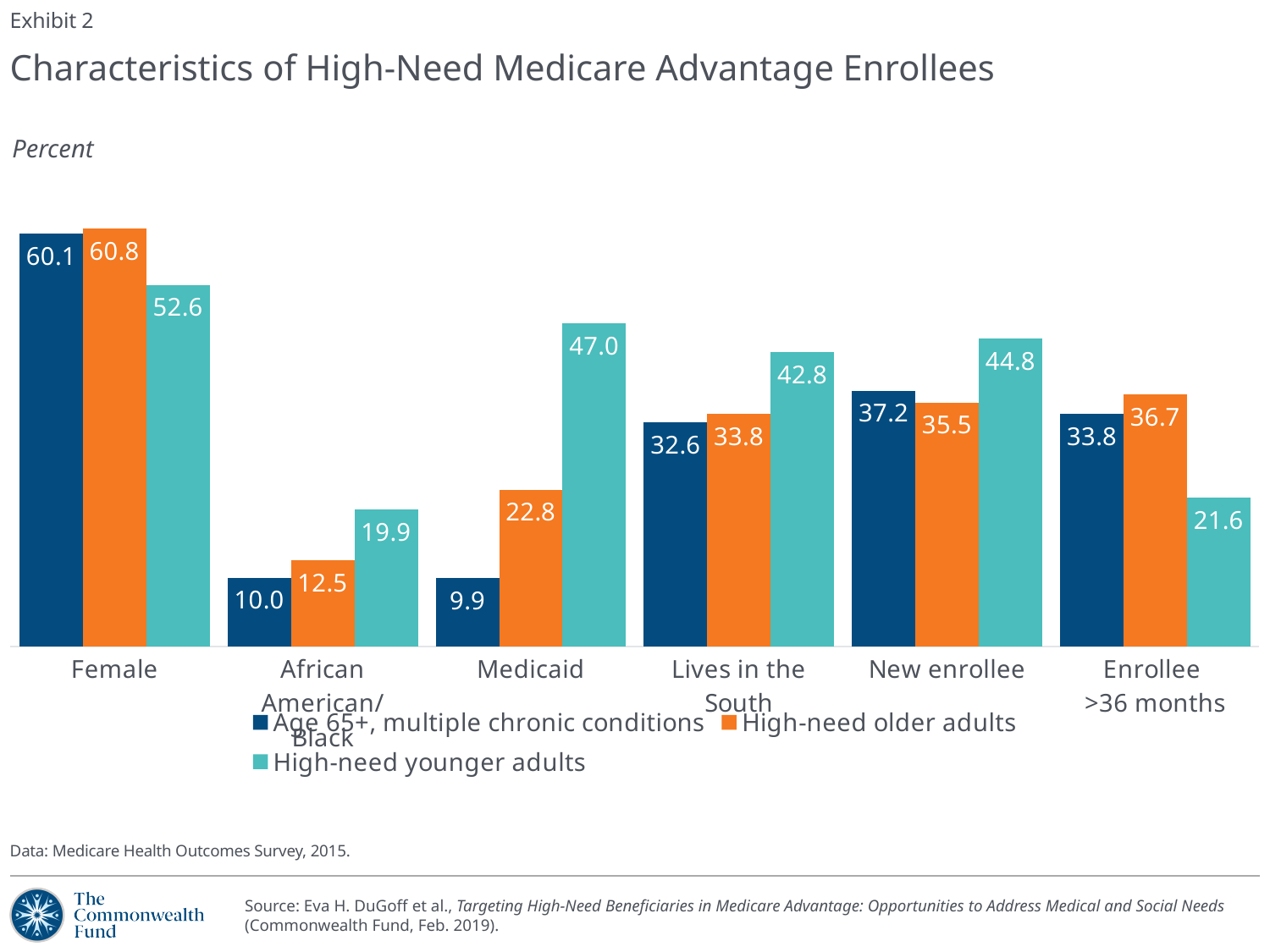
What is the value for High-need older adults in the Enrollee >36 months category? 36.7 Which category has the lowest value for Age 65+, multiple chronic conditions? Medicaid What is the value for High-need younger adults in the Medicaid category? 47.0 What is the value for Age 65+, multiple chronic conditions in the Female category? 60.1 How many categories are shown on the x axis? 6 What unit is the chart measured in, according to the subtitle? Percent What is the difference between High-need younger adults and High-need older adults in the Medicaid category? 24.2 Which category has the highest value for High-need younger adults? Female What is the difference between High-need older adults and Age 65+, multiple chronic conditions in the Female category? 0.7 What kind of chart is shown on the slide? Bar chart How many series does the legend list? 3 In the New enrollee category, which is larger: Age 65+, multiple chronic conditions or High-need older adults? Age 65+, multiple chronic conditions